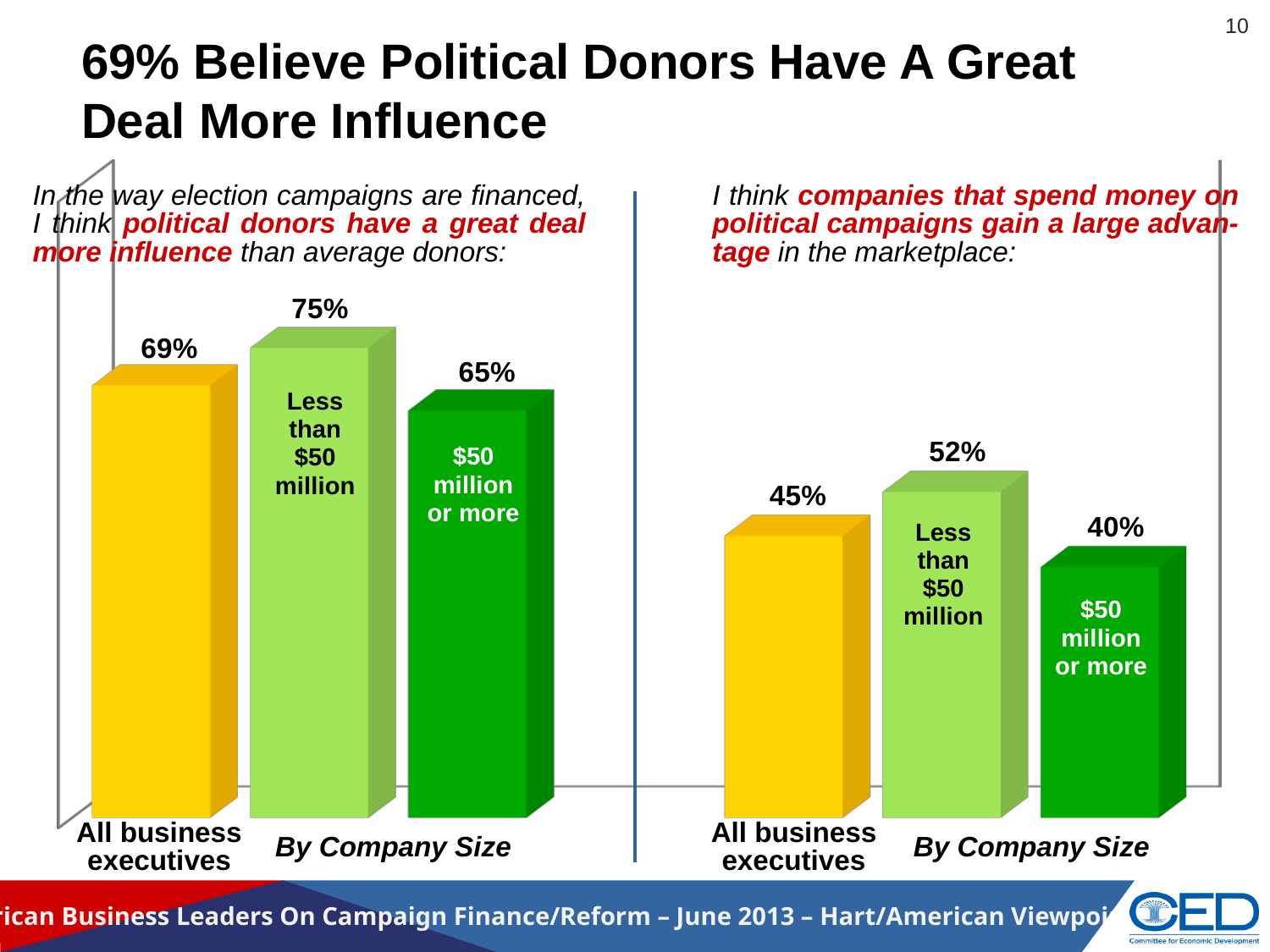
In the right chart (companies that spend money on political campaigns gain a large advantage), which category has the lowest value? $50 million or more In the left chart (political donors have a great deal more influence), what is the difference between the values for less than $50 million and $50 million or more? 10% In the right chart (companies that spend money on political campaigns gain a large advantage), which is larger: the value for All business executives or for $50 million or more? All business executives In the right chart (companies that spend money on political campaigns gain a large advantage), what is the value for companies with $50 million or more? 40% In the right chart (companies that spend money on political campaigns gain a large advantage), what is the difference between the values for less than $50 million and All business executives? 7% What kind of chart is the right chart (companies that spend money on political campaigns gain a large advantage)? Bar chart In the left chart (political donors have a great deal more influence), what is the value for All business executives? 69% In the right chart (companies that spend money on political campaigns gain a large advantage), what is the value for All business executives? 45% In the left chart (political donors have a great deal more influence), which category has the highest value? Less than $50 million How many bars are shown in the left chart (political donors have a great deal more influence)? 3 In the left chart (political donors have a great deal more influence), what colour is the bar for All business executives? Yellow In the left chart (political donors have a great deal more influence), what is the value for companies with less than $50 million? 75%